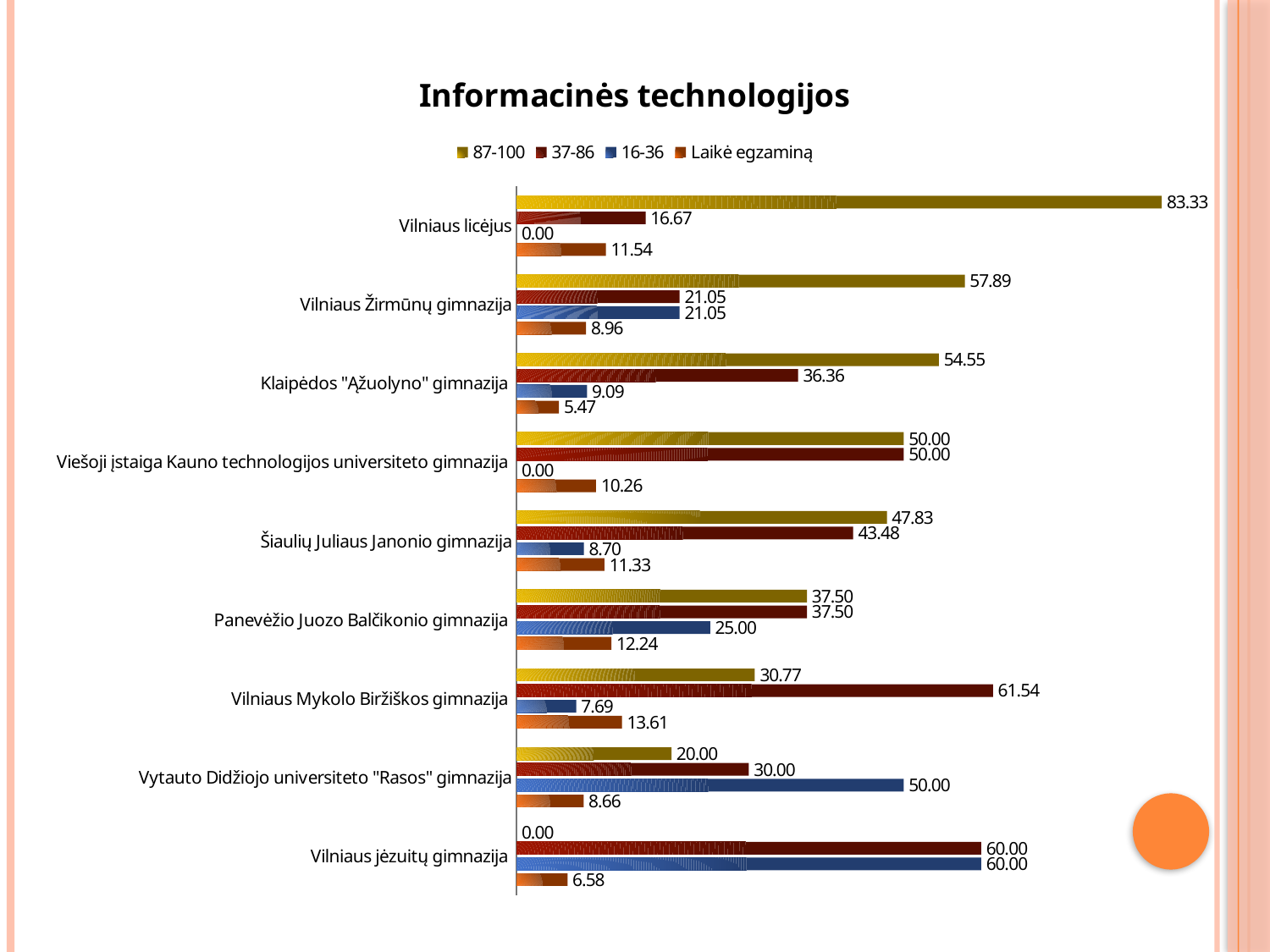
Which is larger for Vytauto Didžiojo universiteto "Rasos" gimnazija: the 16-36 value or the 37-86 value? 16-36 How many series does the legend list? 4 Which school has the lowest 87-100 value? Vilniaus jėzuitų gimnazija Which school has the highest 87-100 value? Vilniaus licėjus What is the difference between the 37-86 value and the 87-100 value for Vilniaus Mykolo Biržiškos gimnazija? 30.77 What is the 37-86 value for Vilniaus Mykolo Biržiškos gimnazija? 61.54 What is the 16-36 value for Panevėžio Juozo Balčikonio gimnazija? 25.00 How many schools (categories) are shown on the chart? 9 What kind of chart is shown on the slide? Bar chart What is the Laikė egzaminą value for Klaipėdos "Ąžuolyno" gimnazija? 5.47 What is the title of the chart? Informacinės technologijos What is the 87-100 value for Vilniaus licėjus? 83.33